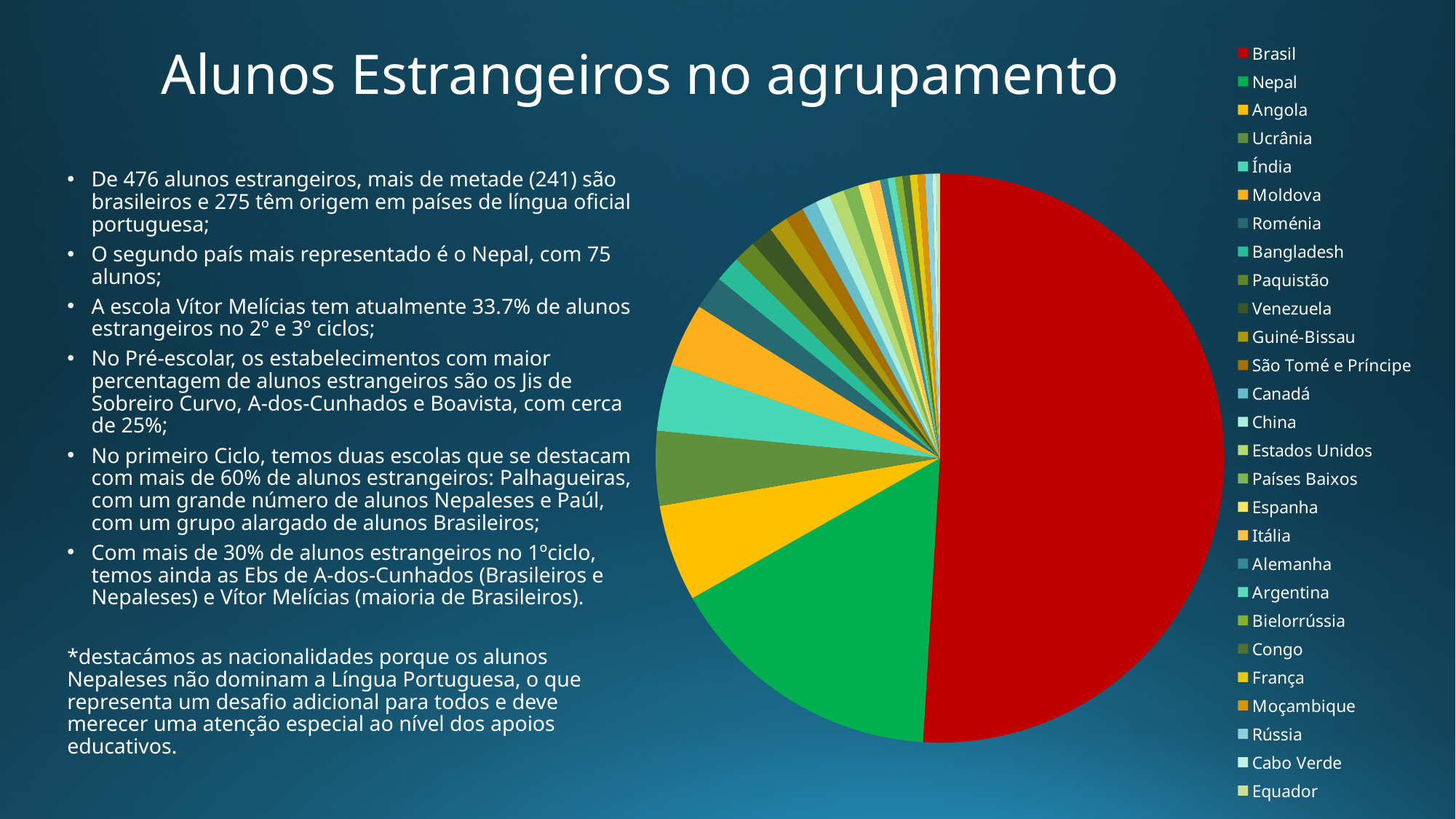
How many categories does the legend list? 27 Which slice is larger, Nepal or Angola? Nepal Is the Brasil slice more or less than half of the pie? more Which slice is larger, Angola or Ucrânia? Angola What kind of chart is shown on the slide? pie chart Which slice is larger, Brasil or Nepal? Brasil Which category has the second largest slice of the pie? Nepal Which category is listed last in the legend? Equador What is the title of the slide containing the pie chart? Alunos Estrangeiros no agrupamento What colour is the Brasil slice in the pie chart? red Which category has the largest slice of the pie? Brasil